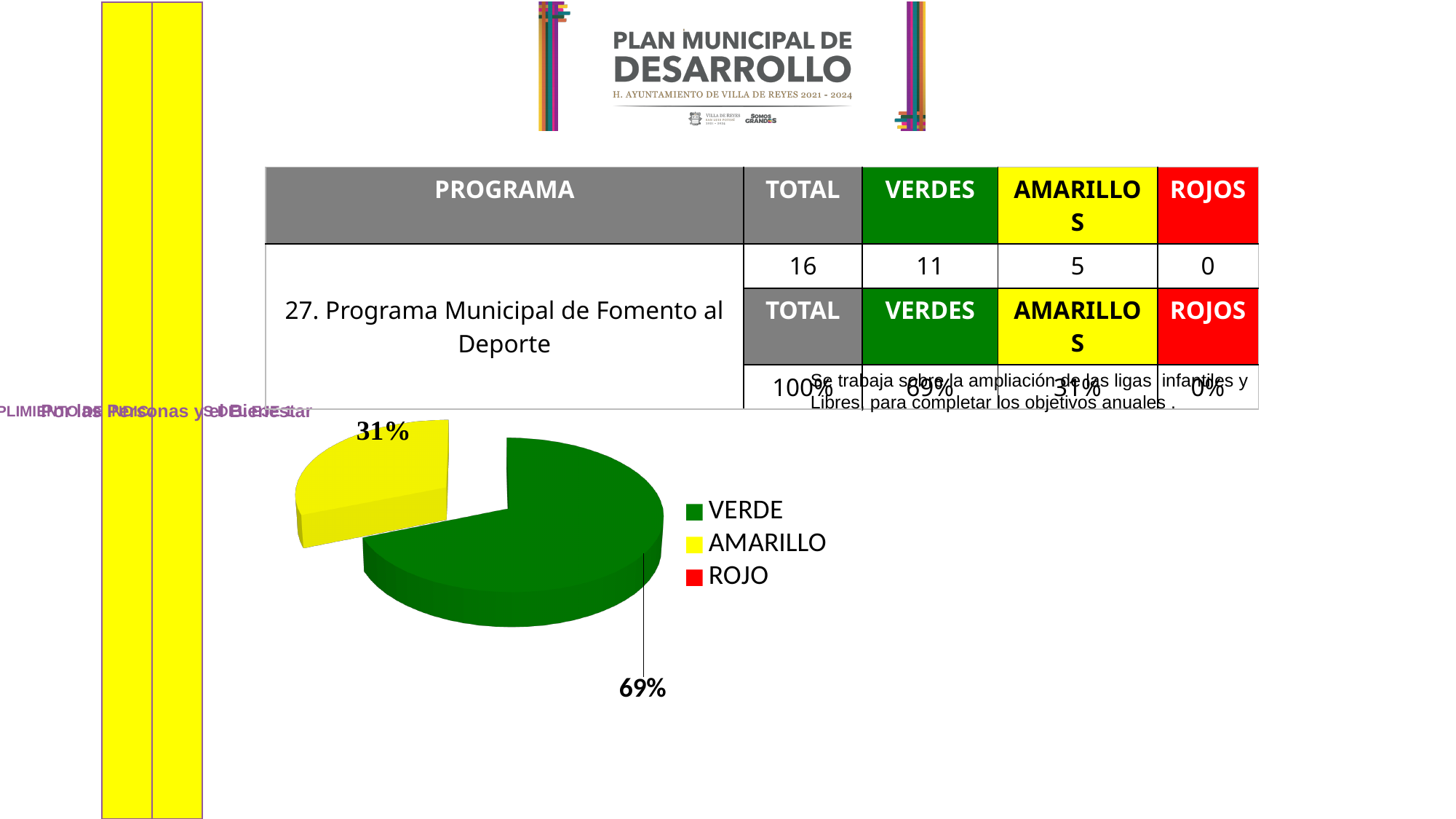
Which of the two visible slices is larger, VERDE or AMARILLO? VERDE What share of the pie chart does AMARILLO represent? 31% How many entries does the pie chart legend list? 3 Which legend entry of the pie chart has no visible slice? ROJO Is the share for AMARILLO greater or less than 50%? less Is the share for VERDE greater or less than 50%? greater What is the difference in percentage points between the VERDE and AMARILLO slices? 38 What share of the pie chart does VERDE represent? 69% What kind of chart is shown on the slide? pie chart Which category has the largest slice in the pie chart? VERDE What colour is the VERDE slice in the pie chart? green